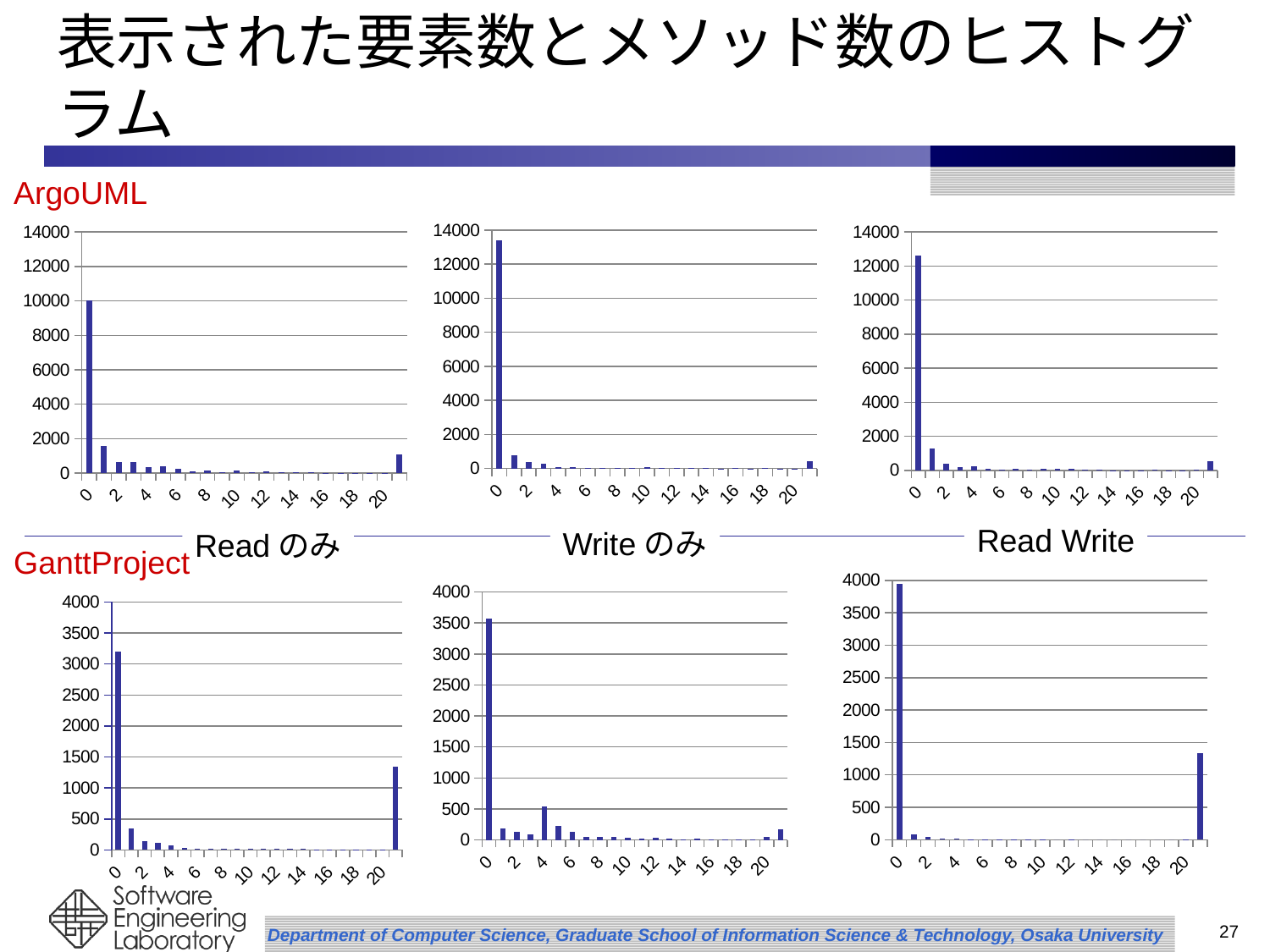
In the ArgoUML Read Write chart, do the values generally rise or fall from category 0 to category 10? fall What kind of chart is used for the ArgoUML Read のみ histogram? bar chart In the ArgoUML Read Write chart, is the value for category 0 greater or less than 10000? greater In the ArgoUML Write のみ chart, which category has the highest value? 0 How many charts are shown on the slide? 6 In the ArgoUML Write のみ chart, is the value for category 0 greater or less than 12000? greater In the GanttProject Write のみ chart, is the value for category 0 greater or less than 3000? greater What is the highest value shown on the y axis of the GanttProject charts? 4000